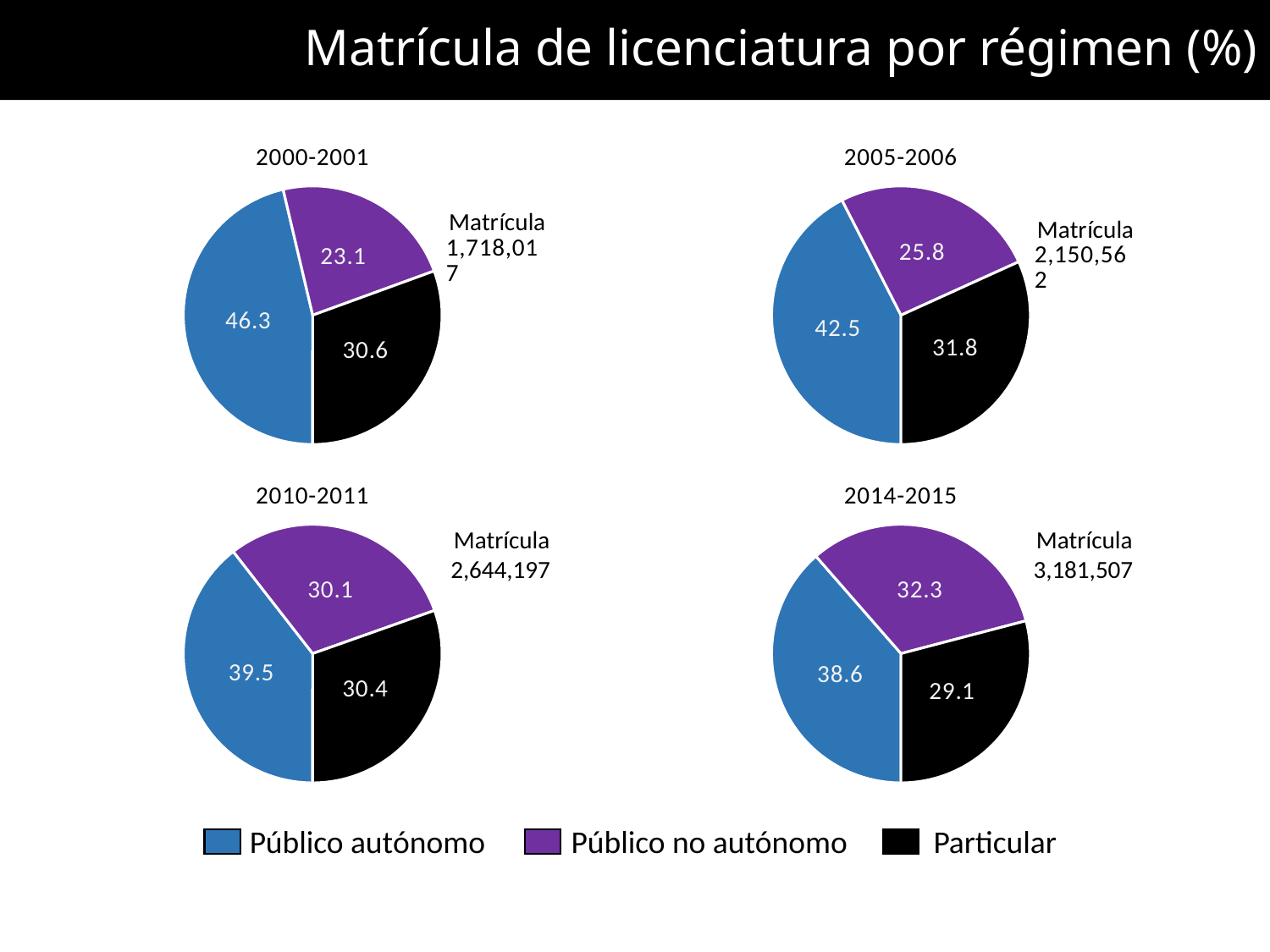
How many slices does the 2010-2011 pie chart have? 3 What Matrícula total is shown next to the 2010-2011 pie chart? 2,644,197 In the 2000-2001 pie chart, what is the value for Público autónomo? 46.3 How many entries does the legend list? 3 In the 2014-2015 pie chart, which category has the smallest slice? Particular In the 2010-2011 pie chart, which category has the largest slice? Público autónomo In the 2000-2001 pie chart, which category has the smallest slice? Público no autónomo In the 2014-2015 pie chart, what is the value for Público no autónomo? 32.3 In the 2000-2001 pie chart, which is larger, Particular or Público no autónomo? Particular In the 2005-2006 pie chart, what is the value for Particular? 31.8 In the 2005-2006 pie chart, what is the difference between the Público autónomo and Público no autónomo values? 16.7 What kind of chart is used for 2014-2015? Pie chart